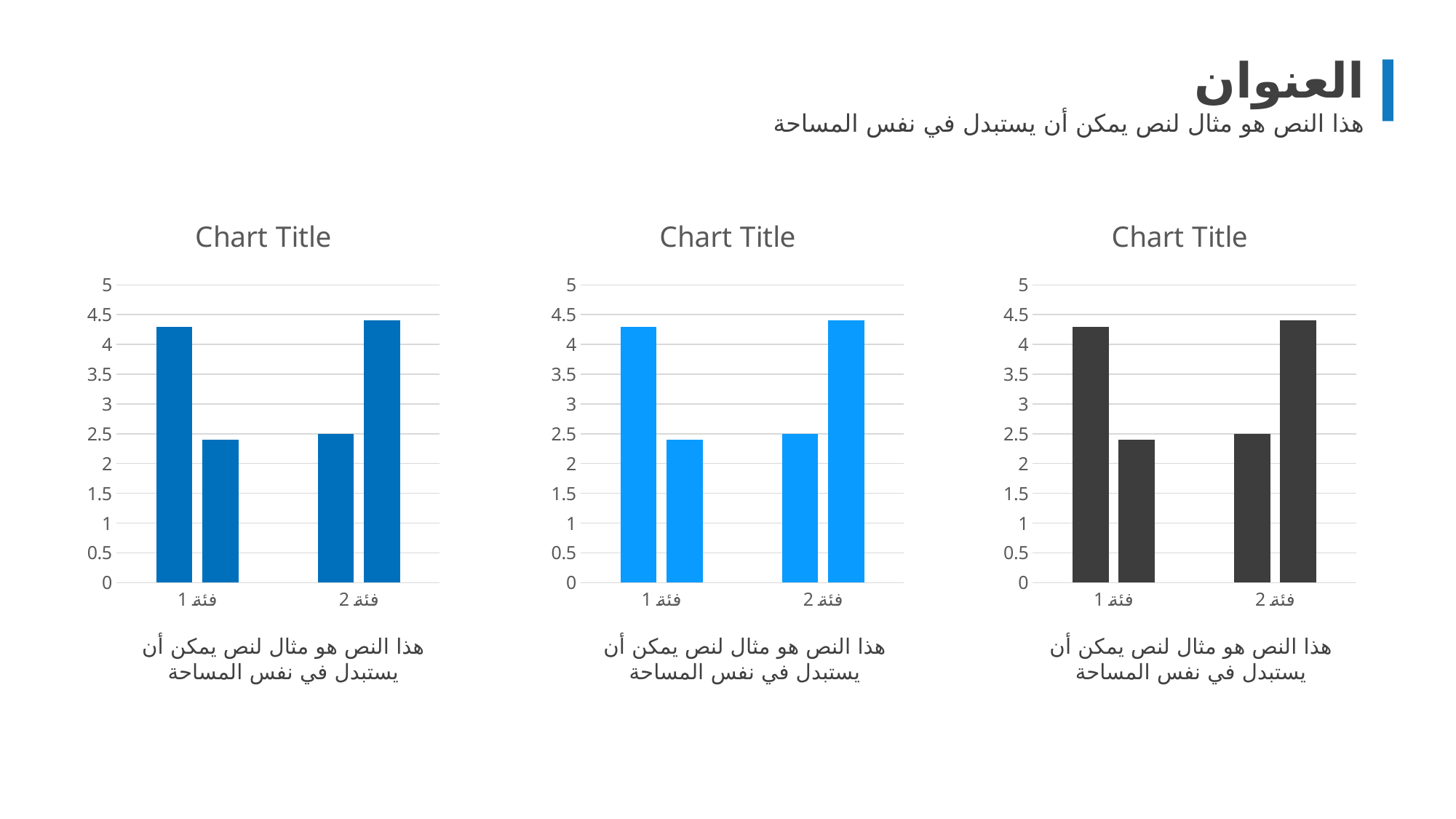
In the right chart, which bar for فئة 2 is taller, the left bar or the right bar? the right bar What kind of chart is the left chart on the slide? bar chart What is the title of the right chart? Chart Title What is the highest value shown on the vertical axis of the left chart? 5 In the right chart, which bar for فئة 1 is taller, the left bar or the right bar? the left bar In the left chart, is the value of the left bar for فئة 1 greater or less than 4? greater How many categories are shown on the x axis of the middle chart? 2 In the left chart, is the value of the right bar for فئة 1 greater or less than 3? less In the middle chart, is the value of the right bar for فئة 2 greater or less than 4? greater How many bars are plotted in the right chart? 4